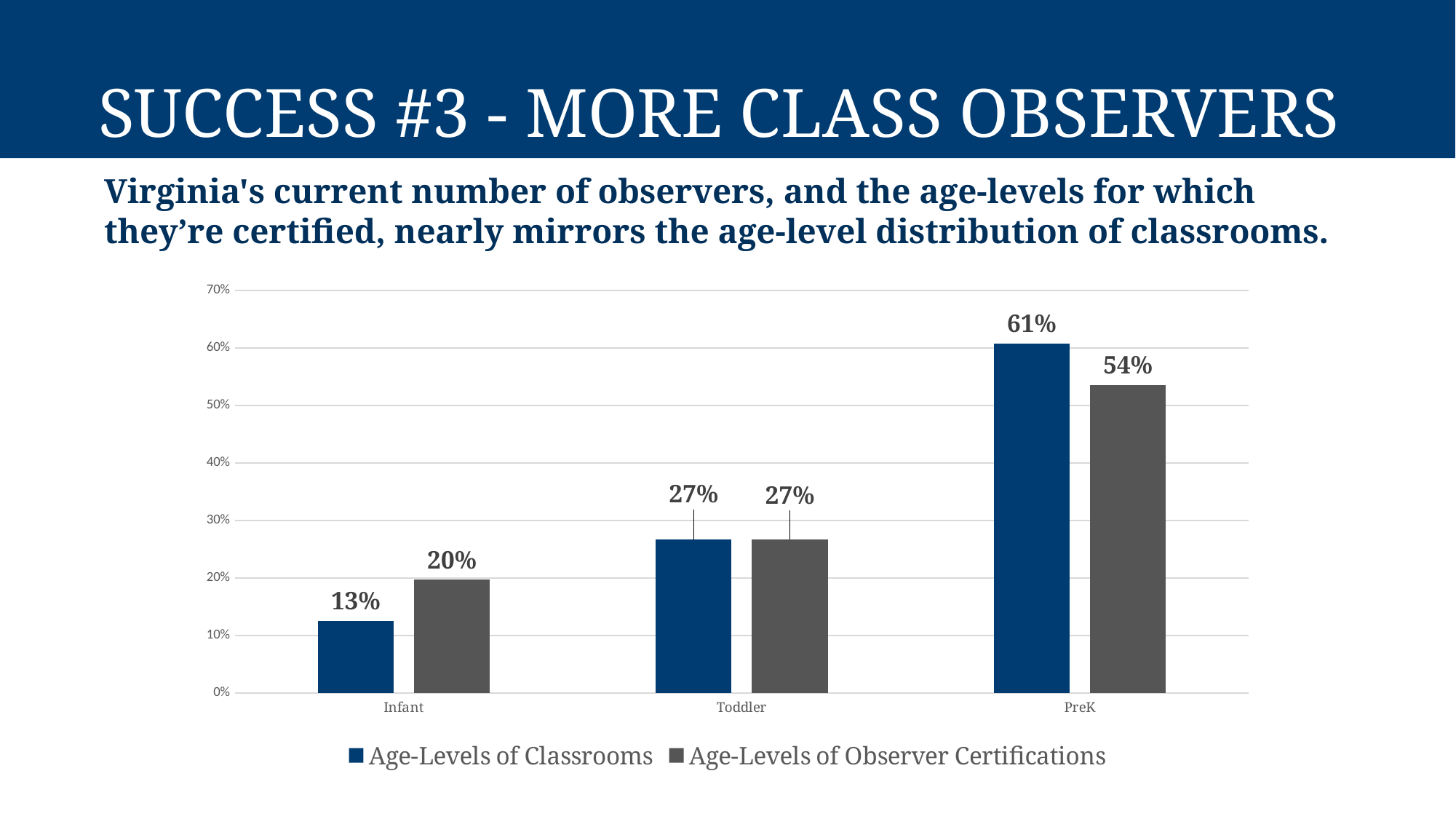
Which age level has the lowest value for Age-Levels of Observer Certifications? Infant How many age-level categories are shown on the x axis? 3 Do the Age-Levels of Classrooms values rise or fall from Infant to PreK? Rise What is the value for Age-Levels of Classrooms for Infant? 13% What is the difference between Age-Levels of Classrooms and Age-Levels of Observer Certifications for PreK? 7% Which age level has the highest value for Age-Levels of Classrooms? PreK For Infant, which is larger: Age-Levels of Classrooms or Age-Levels of Observer Certifications? Age-Levels of Observer Certifications What is the value for Age-Levels of Observer Certifications for PreK? 54% What kind of chart is shown on the slide? Bar chart Is the value for Age-Levels of Classrooms for PreK greater or less than 50%? greater What is the value for Age-Levels of Observer Certifications for Toddler? 27% How many series does the legend list? 2